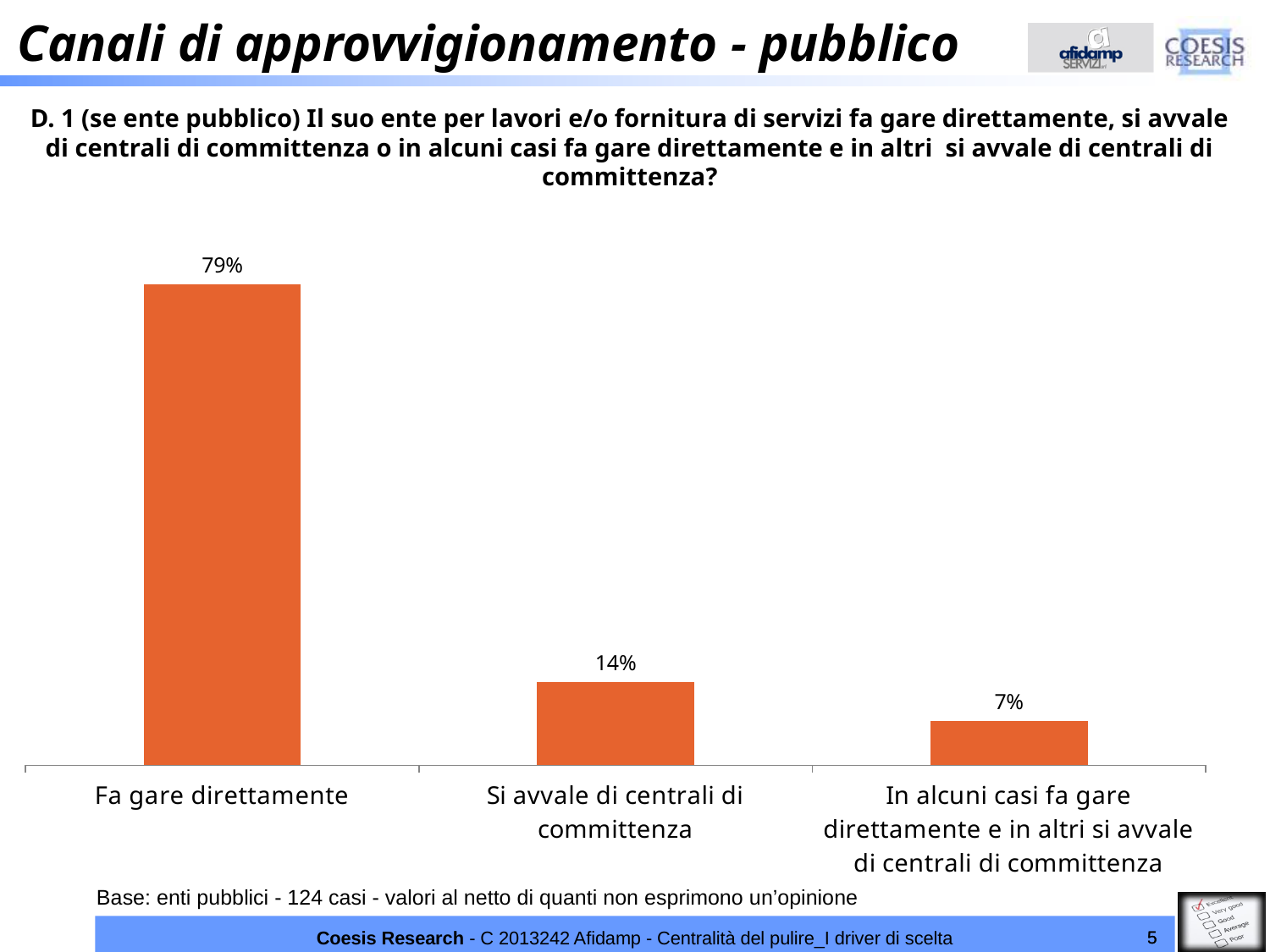
Which category has the lowest value? In alcuni casi fa gare direttamente e in altri si avvale di centrali di committenza Which is larger: the value for "Si avvale di centrali di committenza" or the value for "In alcuni casi fa gare direttamente e in altri si avvale di centrali di committenza"? Si avvale di centrali di committenza What is the value for "Si avvale di centrali di committenza"? 14% What is the base (number of cases) stated below the chart? 124 casi What is the difference between the values for "Si avvale di centrali di committenza" and "In alcuni casi fa gare direttamente e in altri si avvale di centrali di committenza"? 7% What is the value for "In alcuni casi fa gare direttamente e in altri si avvale di centrali di committenza"? 7% What is the value for "Fa gare direttamente"? 79% What kind of chart is shown on the slide? Bar chart Do the values rise or fall from left to right across the categories? Fall What is the difference between the values for "Fa gare direttamente" and "Si avvale di centrali di committenza"? 65% Which category has the highest value? Fa gare direttamente How many categories are shown in the chart? 3